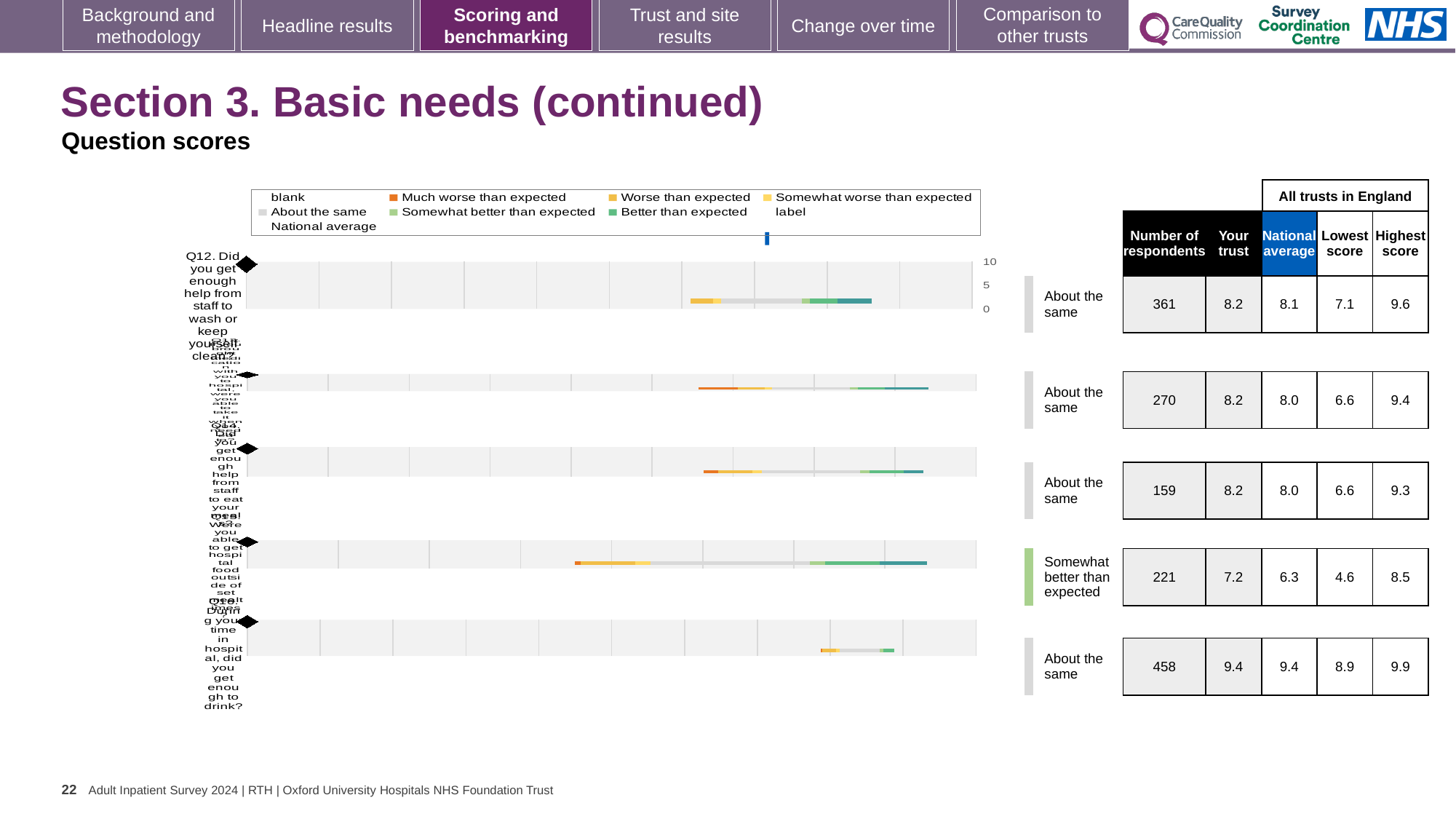
Which benchmark category label is shown next to the Q15 row of the chart? Somewhat better than expected What kind of chart is shown on the slide? bar chart What is the difference between the 'Your trust' score and the 'National average' for Q15 in the table beside the chart? 0.9 Which colour does the chart legend use for 'Much worse than expected'? orange How many question rows (categories) does the chart show? 5 In the table beside the chart, what is the 'Number of respondents' for Q16 (did you get enough to drink)? 458 In the table beside the chart, what is the 'Your trust' score for Q12 (help from staff to wash or keep yourself clean)? 8.2 Which colour does the chart legend use for 'About the same'? grey Which question row has the highest 'Your trust' score in the table beside the chart? Q16 Which question row has the lowest 'Your trust' score in the table beside the chart? Q15 In the table beside the chart, what is the 'National average' for Q15 (hospital food outside of set meal times)? 6.3 Is the 'Your trust' score for Q16 larger than the 'Your trust' score for Q12 in the table beside the chart? Yes